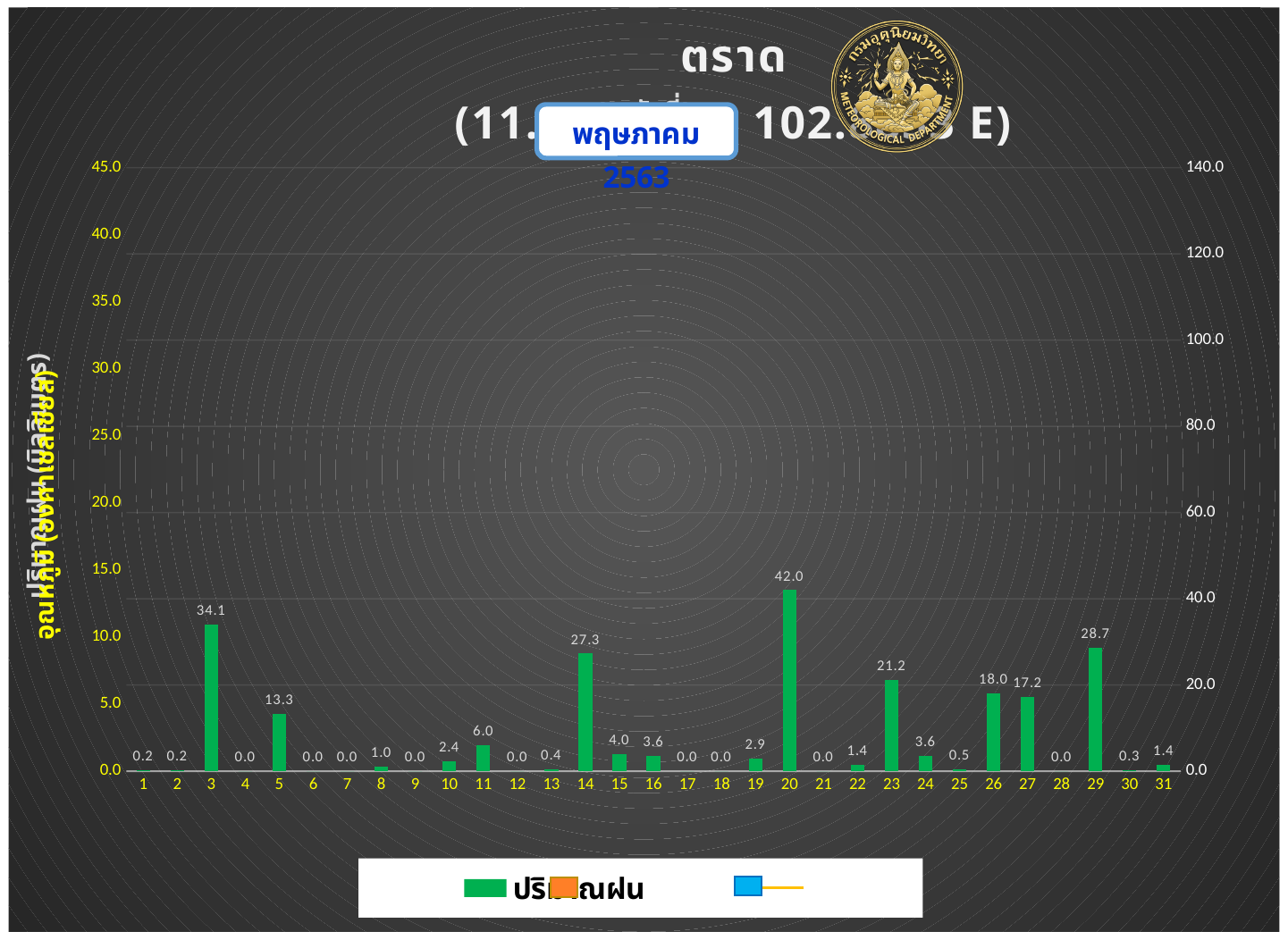
What is the value for day 20? 42.0 What is the difference between the values for day 29 and day 14? 1.4 Which is larger, the value for day 26 or the value for day 27? day 26 What is the value for day 23? 21.2 What is the value for day 29? 28.7 Which day has the highest value? 20 How many days are shown on the x axis? 31 What month and year are shown in the label above the chart? พฤษภาคม 2563 What is the value for day 3? 34.1 What is the value for day 14? 27.3 What type of chart is shown on the slide? bar chart What is the difference between the values for day 20 and day 3? 7.9